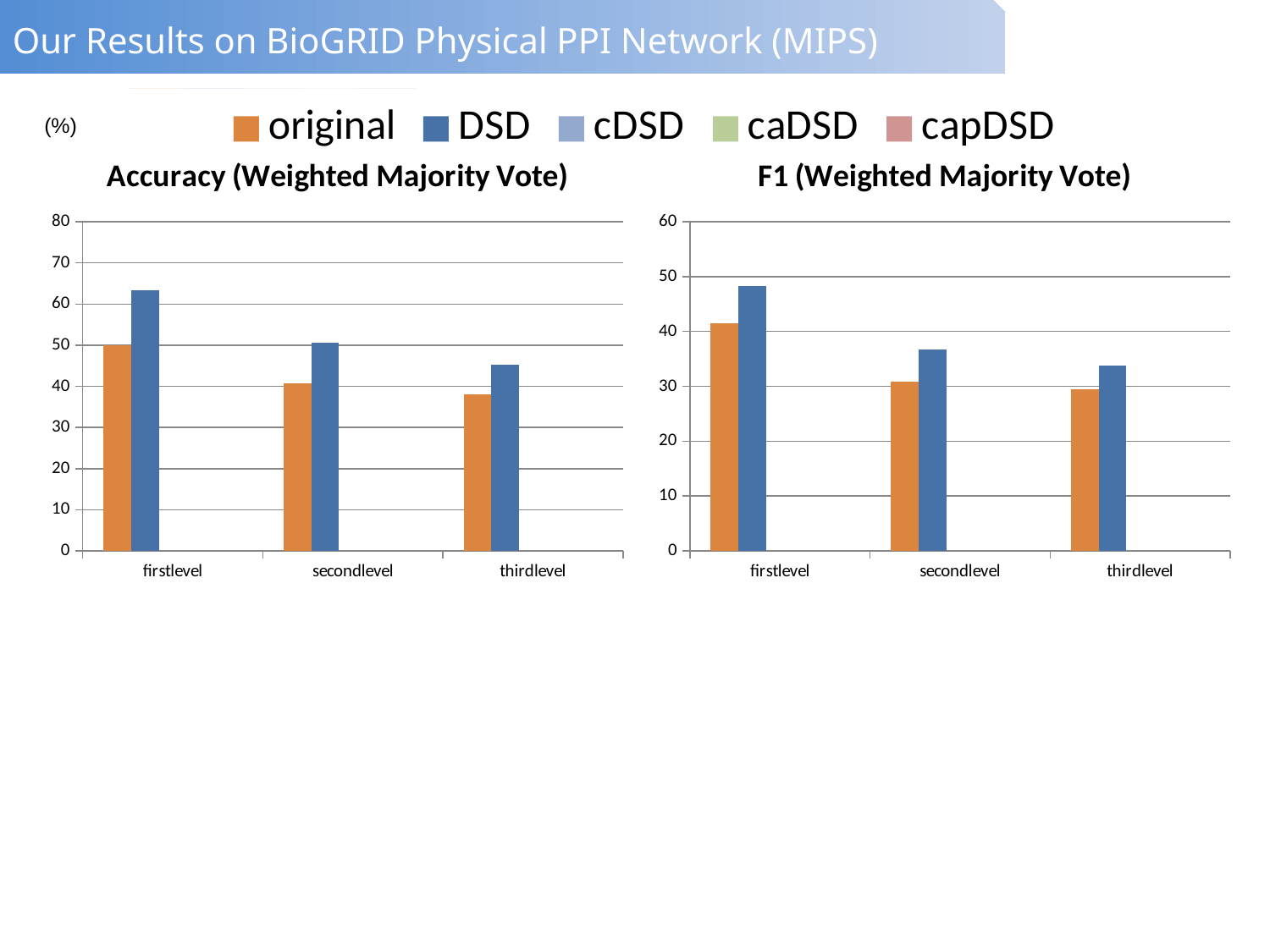
In the F1 (Weighted Majority Vote) chart, is the original value for secondlevel greater or less than 20? greater In the Accuracy (Weighted Majority Vote) chart, which category has the highest DSD value? firstlevel How many series does the legend at the top of the slide list? 5 How many categories are shown on the x axis of the F1 (Weighted Majority Vote) chart? 3 In the Accuracy (Weighted Majority Vote) chart, is the DSD value for firstlevel greater or less than 60? greater In the F1 (Weighted Majority Vote) chart, which is larger for secondlevel, original or DSD? DSD In the Accuracy (Weighted Majority Vote) chart, do the DSD values rise or fall from firstlevel to thirdlevel? fall In the Accuracy (Weighted Majority Vote) chart, is the original value for thirdlevel greater or less than 40? less What kind of chart is the Accuracy (Weighted Majority Vote) chart? bar chart In the F1 (Weighted Majority Vote) chart, which category has the lowest original value? thirdlevel Which series is shown in orange in the legend? original